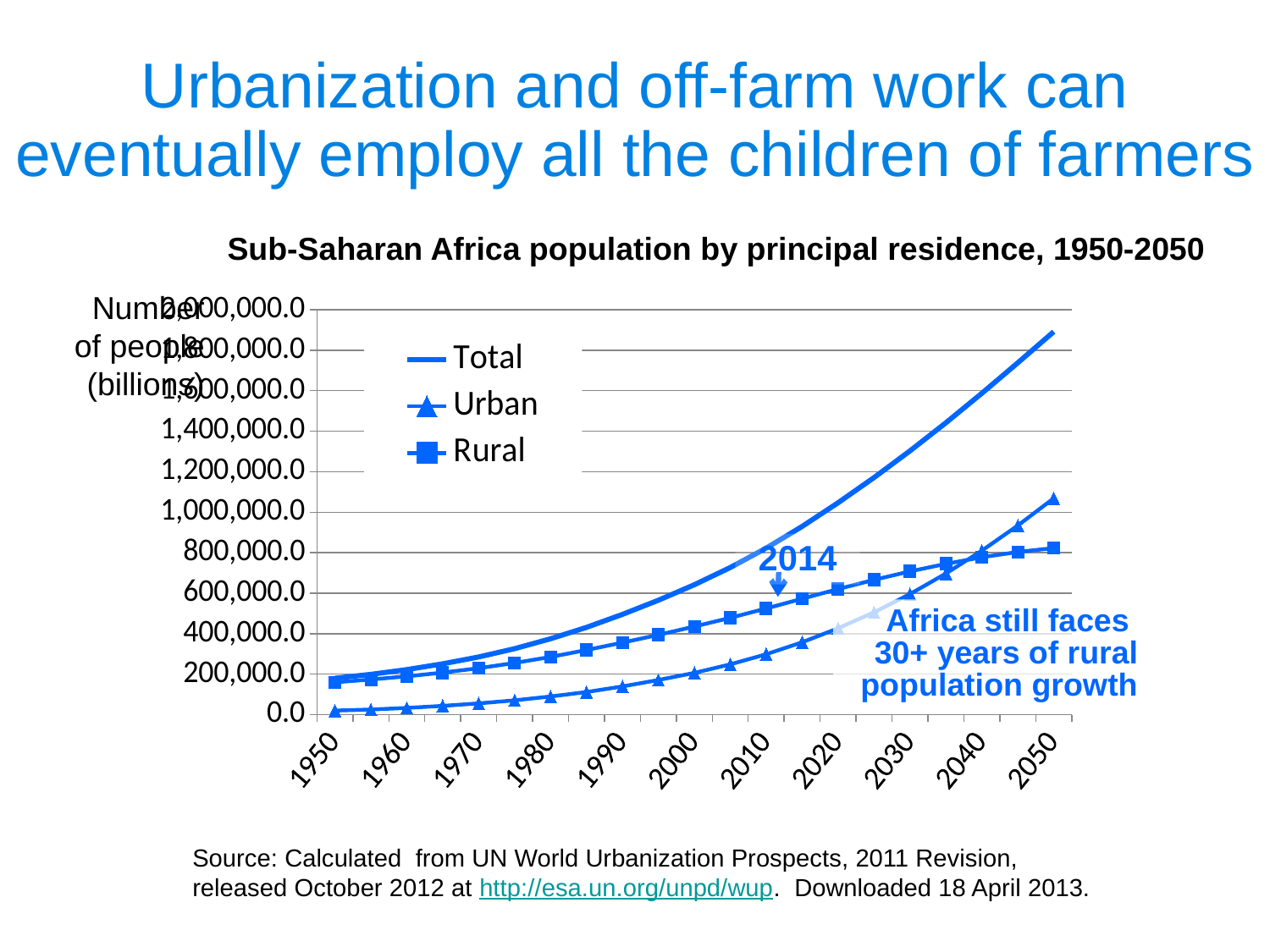
In 2000, which is larger, the Urban value or the Rural value? Rural What are the three series listed in the chart's legend? Total, Urban, Rural Is the Urban value in 2050 greater or less than 1,000,000.0? greater Does the Total series rise or fall from 1950 to 2050? Rise What is the title of the chart? Sub-Saharan Africa population by principal residence, 1950-2050 Is the Rural value in 1950 greater or less than 200,000.0? less What kind of chart is shown on the slide? Line chart How many series does the chart's legend list? 3 How many labelled years appear on the x axis? 11 Which series has the highest value in 2050? Total Which series has the lowest value in 1950? Urban In 2050, which is larger, the Urban value or the Rural value? Urban